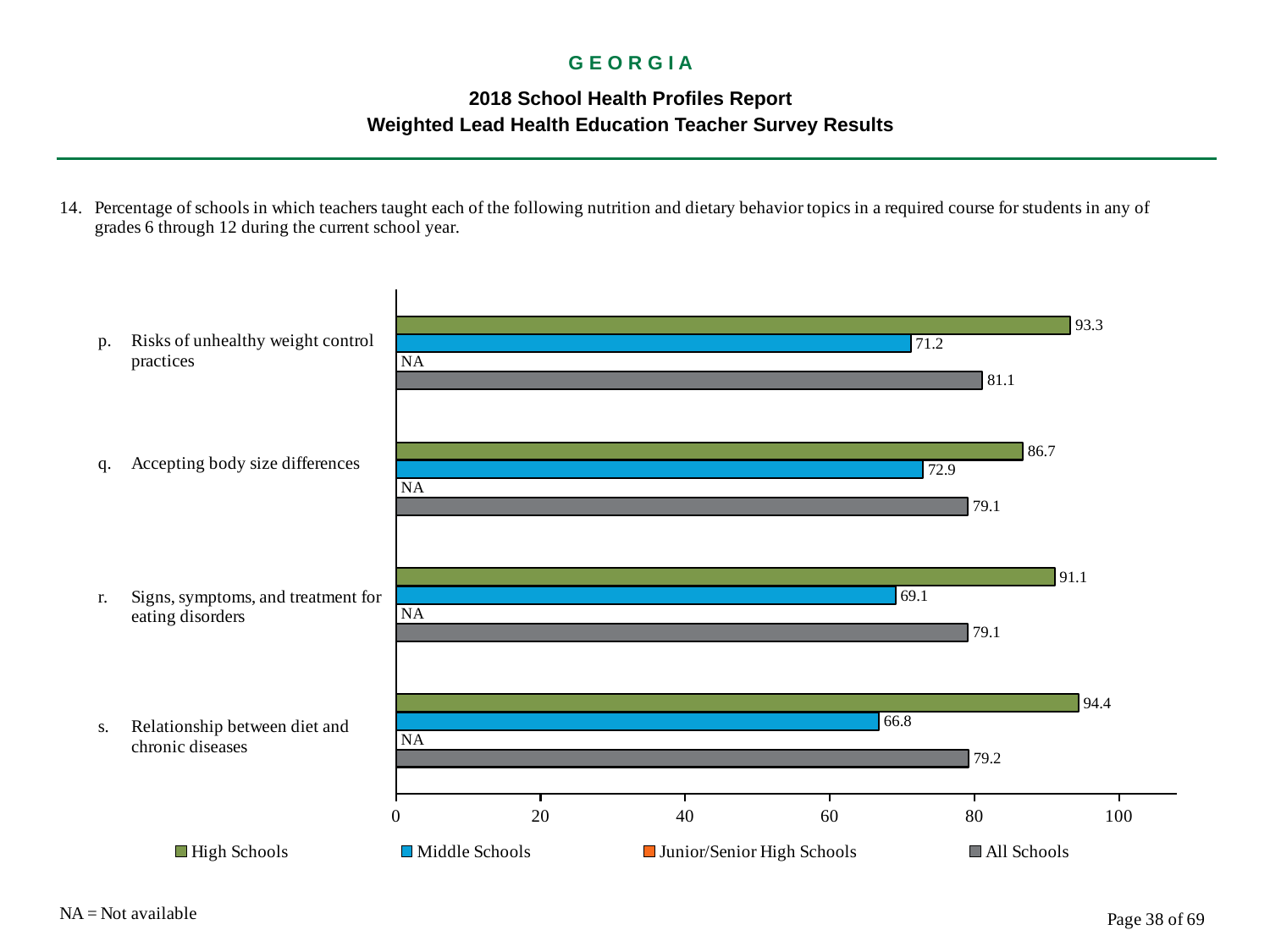
What is the value for High Schools for 'Risks of unhealthy weight control practices'? 93.3 What is the value for Middle Schools for 'Relationship between diet and chronic diseases'? 66.8 How many topics are shown on the chart? 4 Which is larger for 'Accepting body size differences': the High Schools value or the All Schools value? High Schools Is the Middle Schools value for 'Risks of unhealthy weight control practices' greater or less than 80? less How many series does the legend list? 4 What is the difference between the High Schools and Middle Schools values for 'Signs, symptoms, and treatment for eating disorders'? 22 What is shown for Junior/Senior High Schools for 'Signs, symptoms, and treatment for eating disorders'? NA What is the value for All Schools for 'Accepting body size differences'? 79.1 Which topic has the highest value for High Schools? Relationship between diet and chronic diseases Which topic has the lowest value for Middle Schools? Relationship between diet and chronic diseases What kind of chart is shown on the slide? bar chart